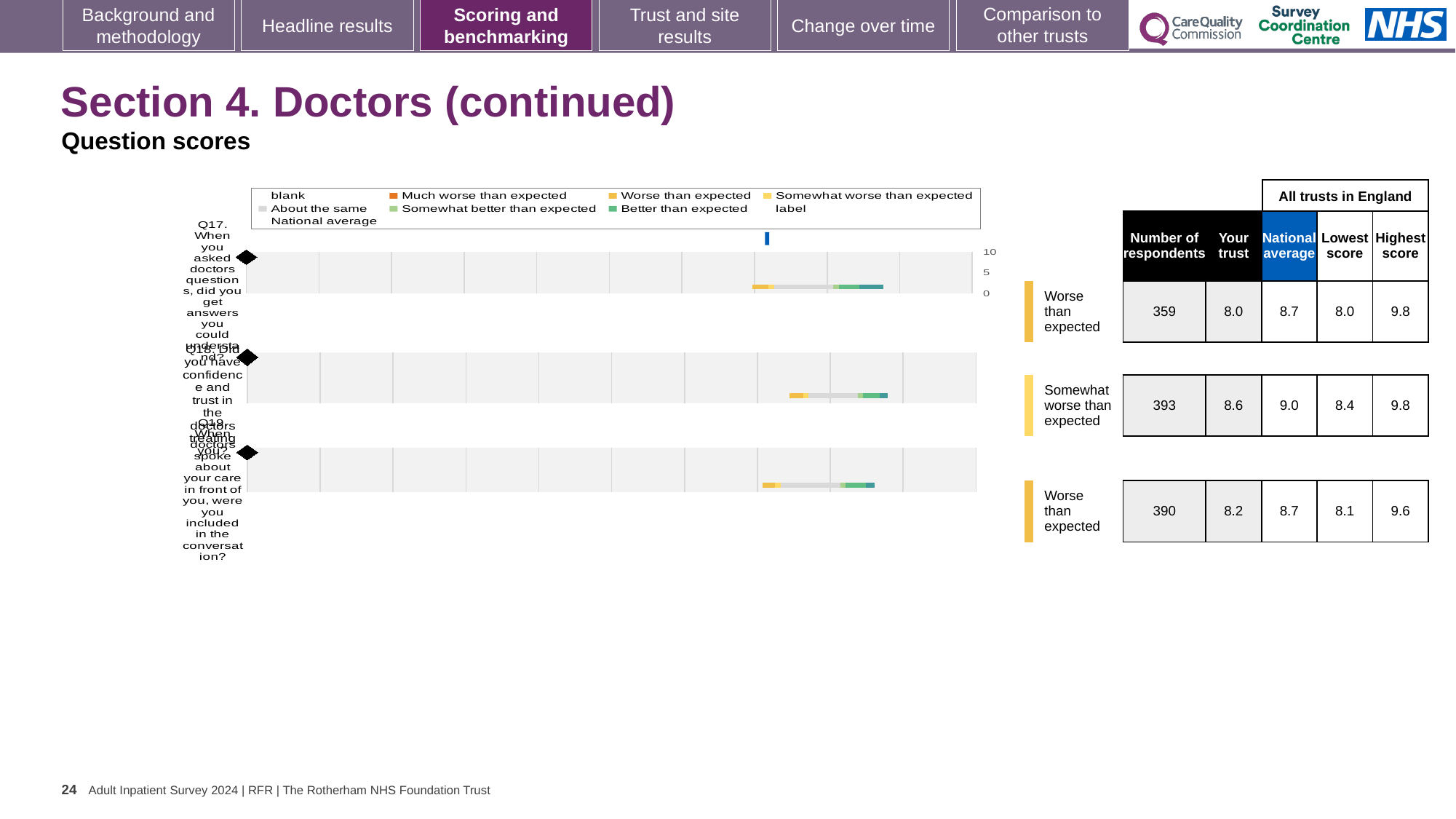
How many entries does the legend of the question scores chart list? 9 What kind of chart is used to show the question scores on this slide? bar chart Which has the higher trust score, Q17 or Q18? Q18 How many respondents answered Q19 (included in the conversation)? 390 How many questions are plotted in the question scores chart? 3 What is the national average score for Q18 (confidence and trust in doctors)? 9.0 Which benchmark category is Q18 placed in? Somewhat worse than expected Which question has the highest number of respondents? Q18 What is the difference between the national average and the trust's score for Q18? 0.4 Which benchmark category is Q17 placed in? Worse than expected What is the trust's score for Q17 (answers you could understand)? 8.0 What is the highest tick value shown on the score axis of the chart? 10